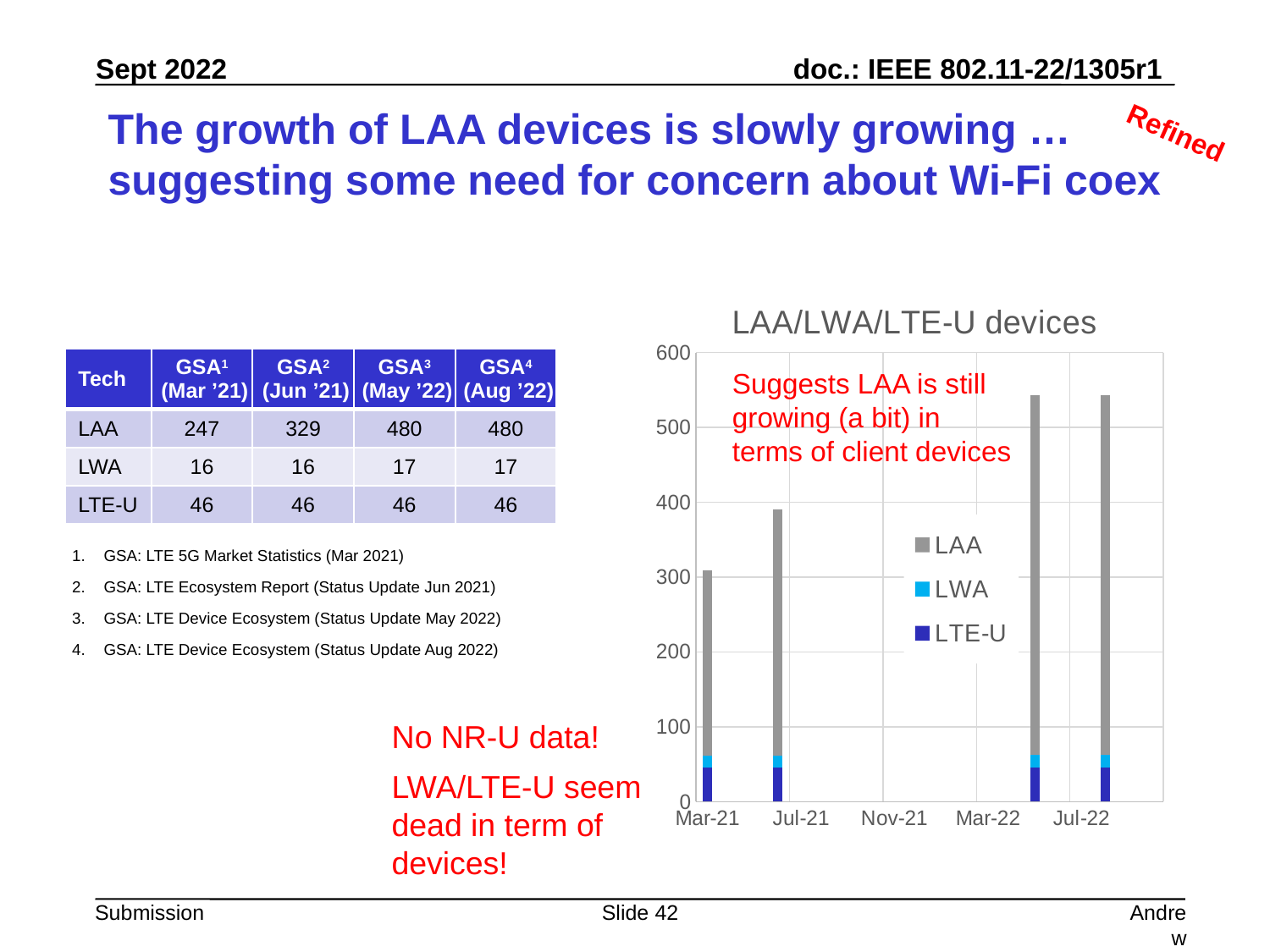
How many stacked bars are plotted in the chart? 4 Is the LTE-U segment of the first bar greater or less than 100? less Which bar in the chart has the lowest total height? Mar-21 Is the total height of the first bar (Mar-21) greater or less than 400? less Is the total height of the second bar (near Jul-21) greater or less than 300? greater What is the title of the chart? LAA/LWA/LTE-U devices Which bar is taller in total: the first bar (Mar-21) or the second bar (near Jul-21)? The second bar (near Jul-21) How many series does the chart legend list? 3 Which series is shown in grey in the chart? LAA Do the total bar heights generally rise or fall from left to right along the x axis? Rise What type of chart is shown on the slide? Stacked bar chart